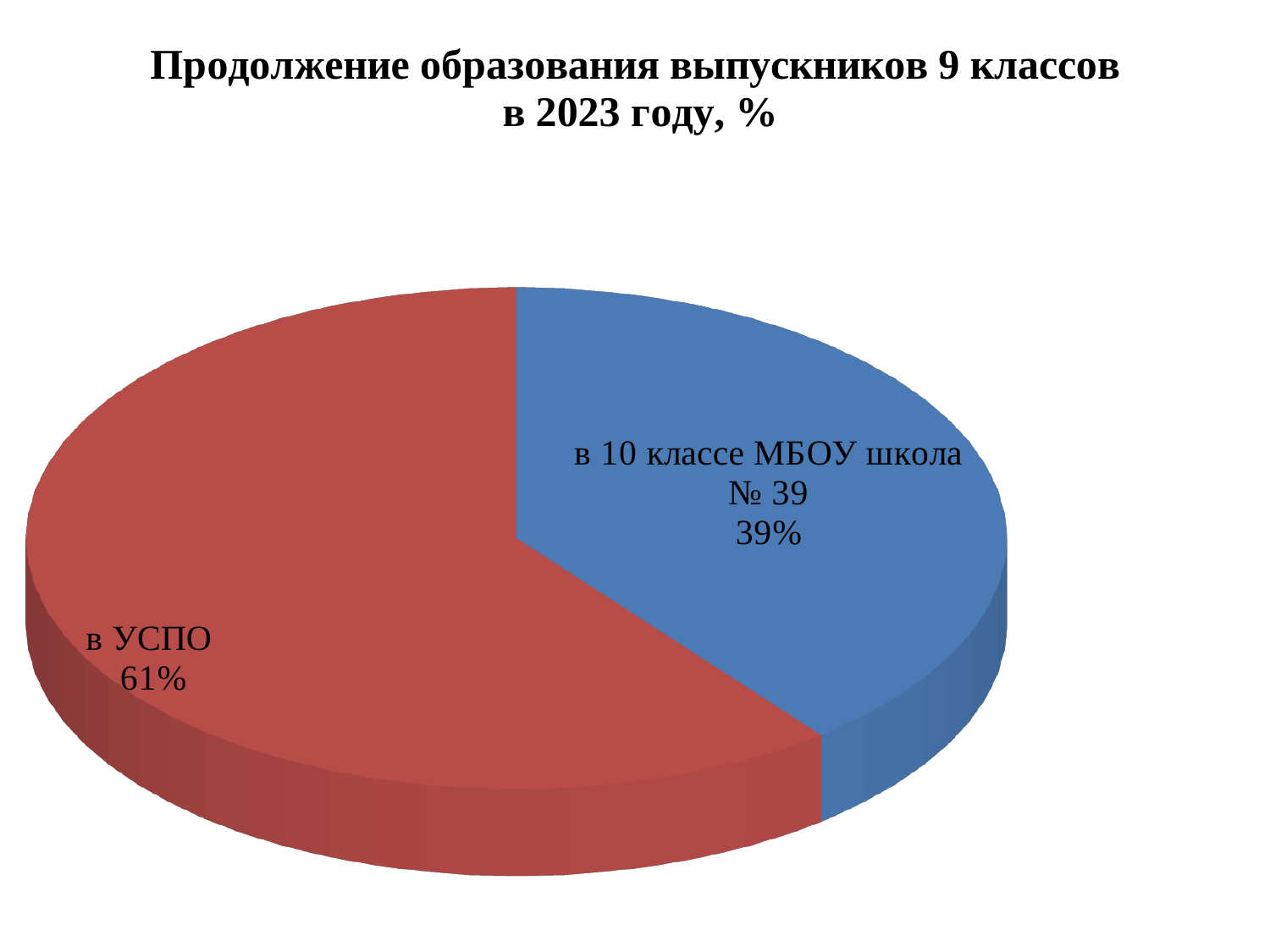
Which slice of the pie is the smallest? в 10 классе МБОУ школа № 39 Is the share for "в 10 классе МБОУ школа № 39" greater or less than 50%? less What colour is the slice labelled "в УСПО"? red What is the title of the chart? Продолжение образования выпускников 9 классов в 2023 году, % How many slices does the pie chart have? 2 What is the difference in percentage points between the "в УСПО" slice and the "в 10 классе МБОУ школа № 39" slice? 22 Which slice of the pie is the largest? в УСПО What share of the pie is labelled "в УСПО"? 61% Which is larger: the share for "в УСПО" or the share for "в 10 классе МБОУ школа № 39"? в УСПО What share of the pie is labelled "в 10 классе МБОУ школа № 39"? 39% What is the total of the two slices shown on the pie chart? 100% What kind of chart is shown on the slide? pie chart